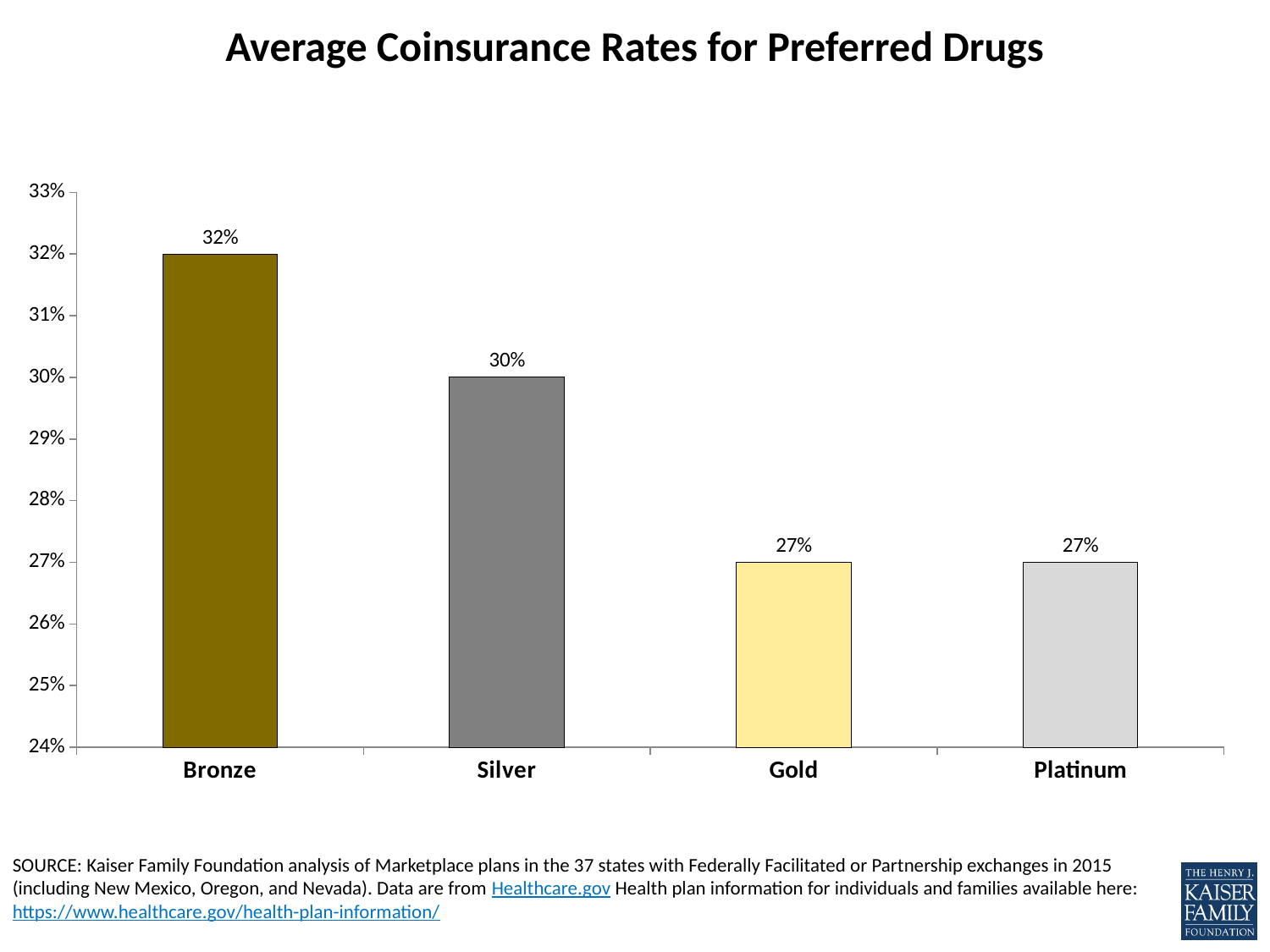
What is the average coinsurance rate for preferred drugs for Gold plans? 27% Which has a higher average coinsurance rate, Silver or Gold? Silver What is the average coinsurance rate for preferred drugs for Platinum plans? 27% What kind of chart is shown on the slide? Bar chart What is the difference between the Bronze and Silver average coinsurance rates? 2% What is the title of the chart? Average Coinsurance Rates for Preferred Drugs What is the difference between the Bronze and Gold average coinsurance rates? 5% What is the average coinsurance rate for preferred drugs for Silver plans? 30% What is the average coinsurance rate for preferred drugs for Bronze plans? 32% How many plan tiers are shown on the chart? 4 Is the value for Silver greater or less than 29%? greater Which plan tier has the highest average coinsurance rate for preferred drugs? Bronze